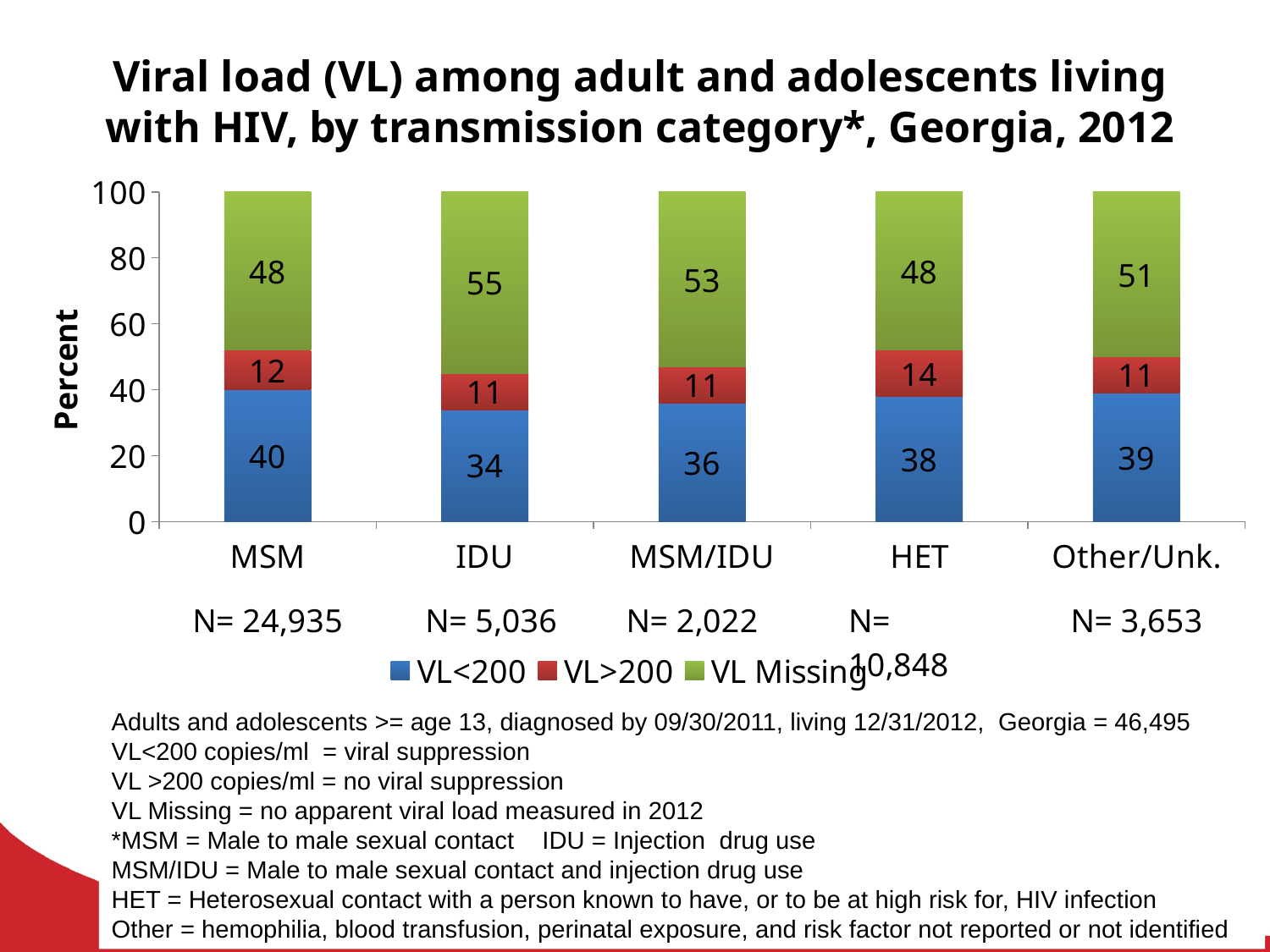
What is the difference between the VL Missing values for IDU and MSM? 7 Which transmission category has the highest VL Missing value? IDU Which transmission category has the highest VL<200 value? MSM What is the VL<200 value for MSM? 40 What is the VL>200 value for HET? 14 How many transmission categories are shown on the x axis? 5 What kind of chart is shown on the slide? Stacked bar chart Which is larger, the VL>200 value for HET or for Other/Unk.? HET What is the VL Missing value for IDU? 55 How many series does the legend list? 3 Which transmission category has the lowest VL<200 value? IDU What is the total of the stacked bar for MSM/IDU? 100